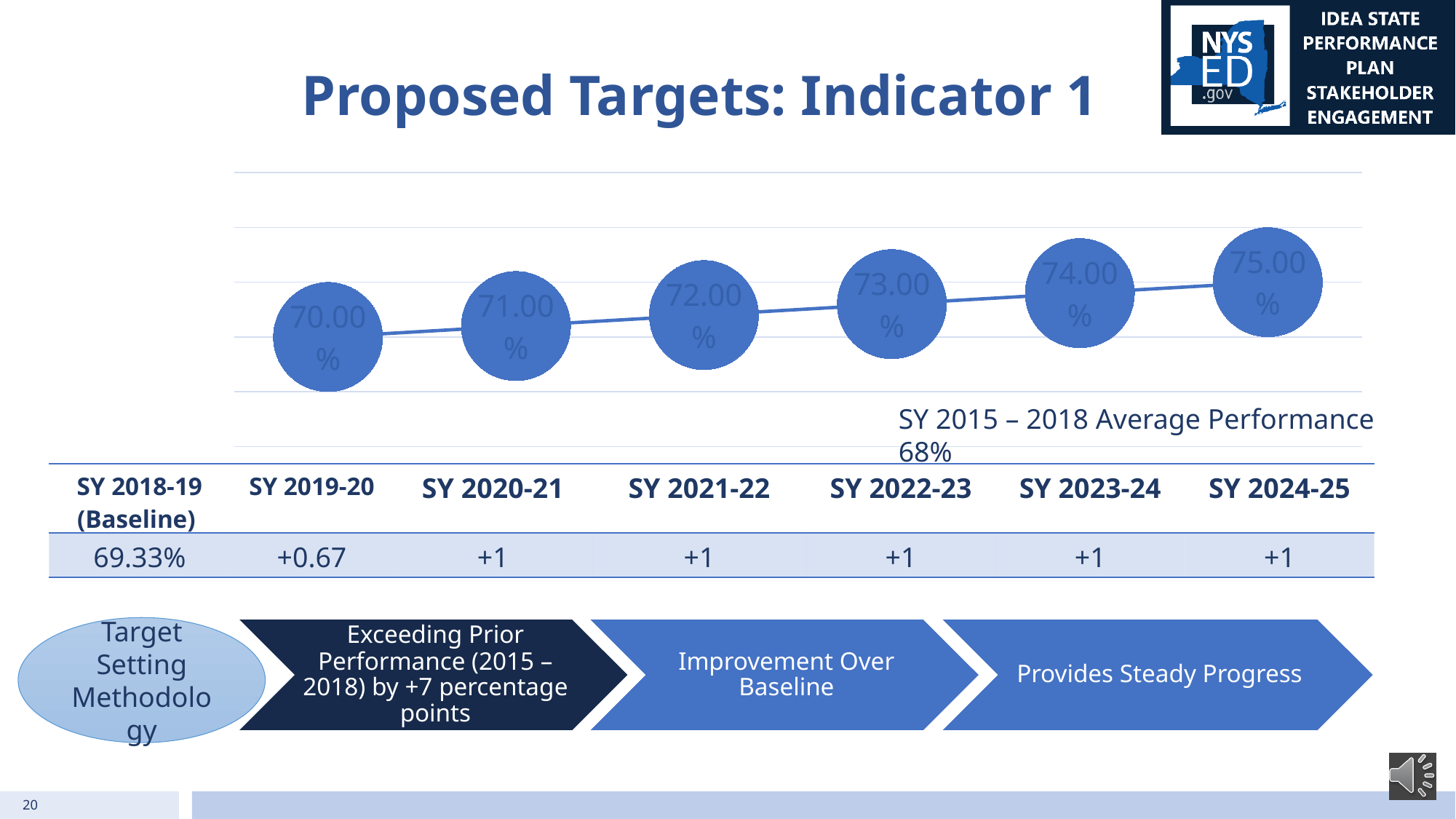
What is the value of the fifth data point from the left on the chart? 74.00% Which data point on the chart has the highest value? the last (rightmost) point, 75.00% What type of chart is shown on the slide? line chart How many data points are plotted on the chart? 6 Do the values on the chart rise or fall from left to right? rise What is the value of the rightmost (last) data point on the chart? 75.00% What is the difference between the last data point (75.00%) and the first data point (70.00%) on the chart? 5.00% What is the title of the slide containing the chart? Proposed Targets: Indicator 1 What is the value of the leftmost (first) data point on the chart? 70.00% What is the value of the third data point from the left on the chart? 72.00% Which is larger, the fourth data point or the second data point on the chart? the fourth data point (73.00%) Which data point on the chart has the lowest value? the first (leftmost) point, 70.00%